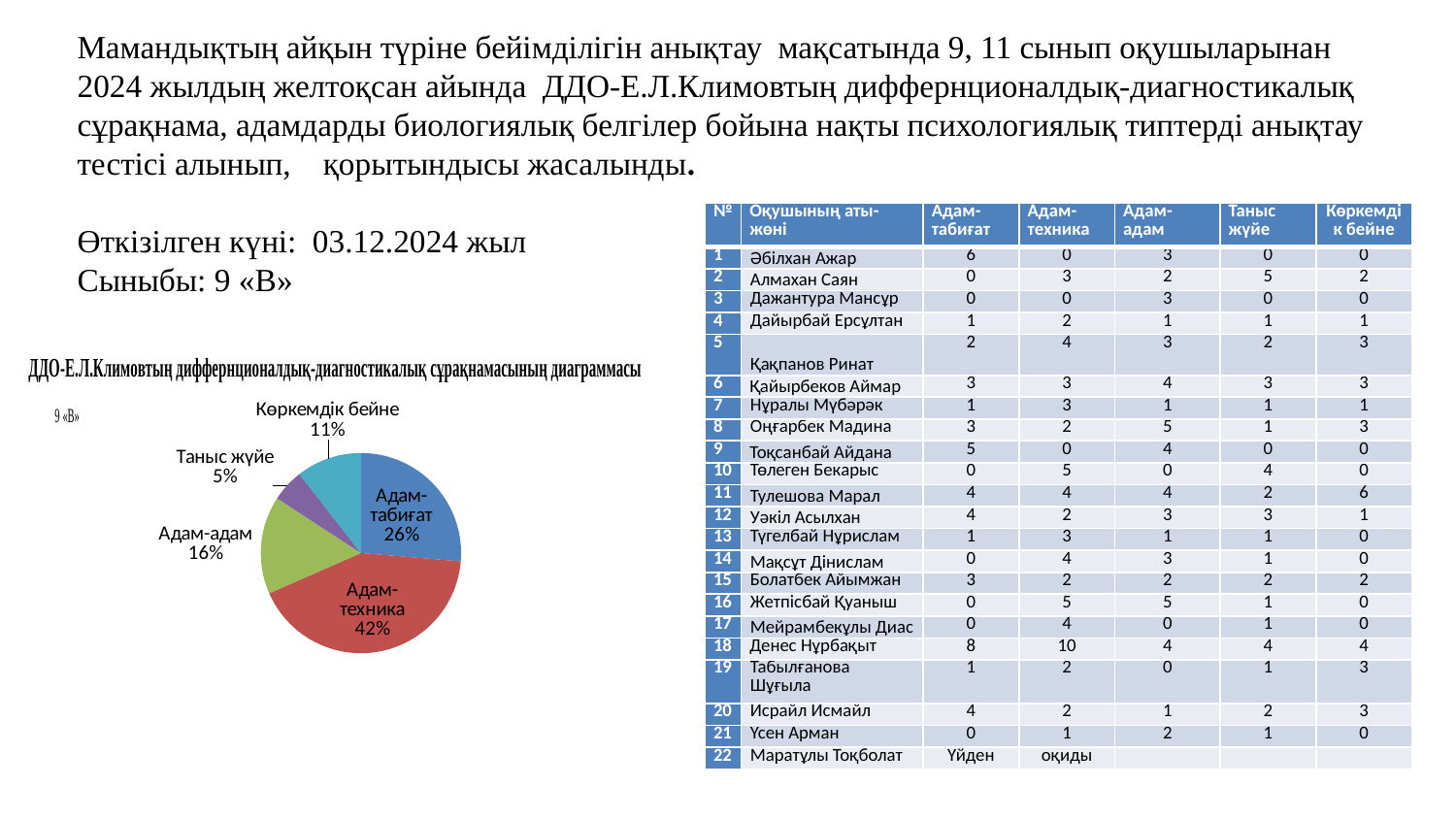
What kind of chart is shown on the slide? pie chart Which is larger, the share for Адам-адам or the share for Көркемдік бейне? Адам-адам What share of the pie does Таныс жүйе have? 5% What share of the pie does Адам-табиғат have? 26% What share of the pie does Көркемдік бейне have? 11% What is the difference in percentage points between Адам-техника and Адам-табиғат? 16 How many slices does the pie chart have? 5 What share of the pie does Адам-техника have? 42% Which slice of the pie is the smallest? Таныс жүйе What is the combined share of Адам-табиғат and Адам-техника? 68% Which slice of the pie is the largest? Адам-техника What share of the pie does Адам-адам have? 16%